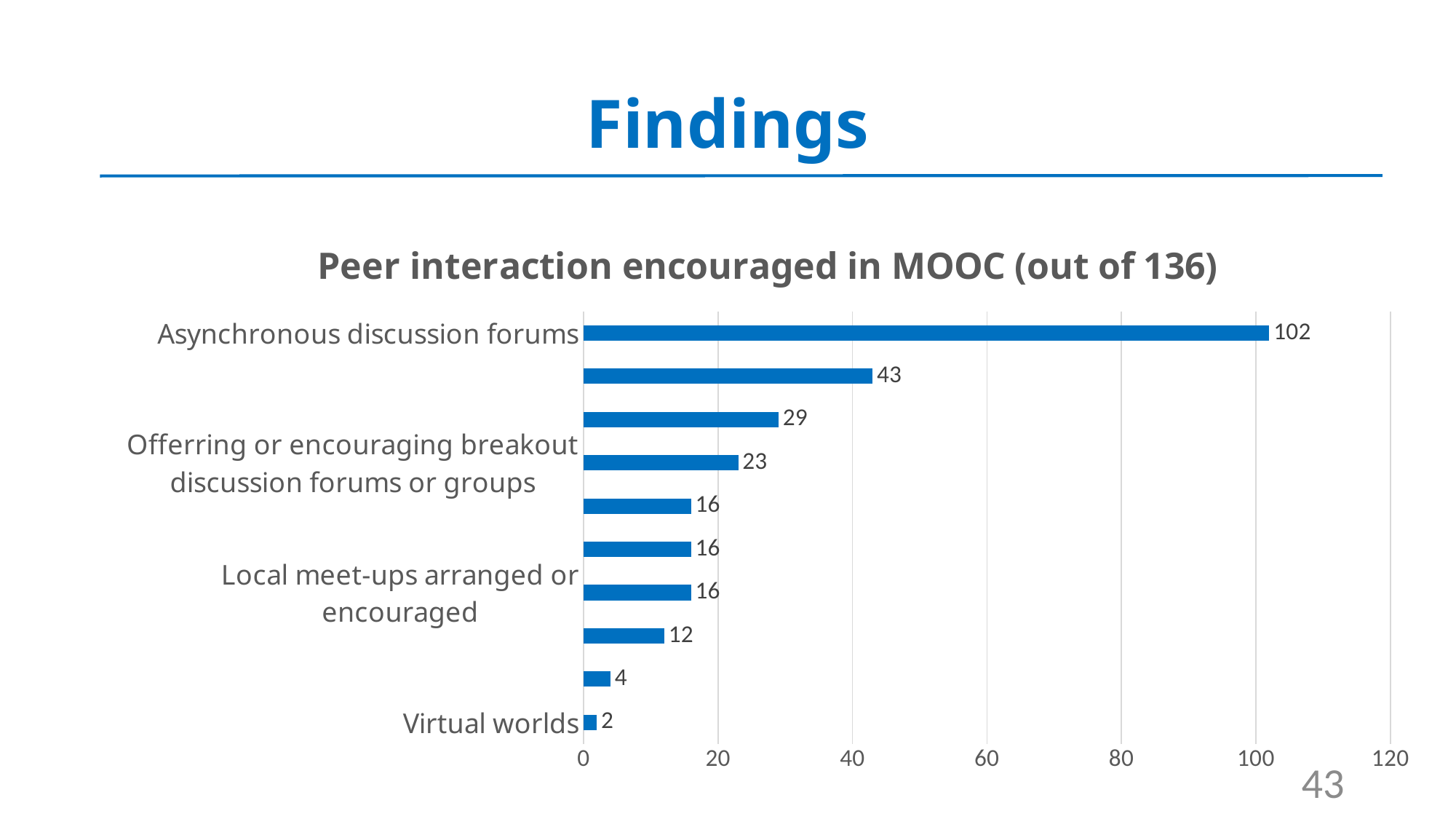
How many bars are plotted in the chart? 10 Which category has the highest value? Asynchronous discussion forums What is the value for Virtual worlds? 2 Is the value for Asynchronous discussion forums greater or less than 100? greater Which is larger, the value for Offerring or encouraging breakout discussion forums or groups or the value for Local meet-ups arranged or encouraged? Offerring or encouraging breakout discussion forums or groups What is the difference between the values for Asynchronous discussion forums and Offerring or encouraging breakout discussion forums or groups? 79 What kind of chart is shown on the slide? bar chart What is the value for Local meet-ups arranged or encouraged? 16 What is the value for Asynchronous discussion forums? 102 What is the difference between the values for Asynchronous discussion forums and Virtual worlds? 100 Which category has the lowest value? Virtual worlds What is the value for Offerring or encouraging breakout discussion forums or groups? 23